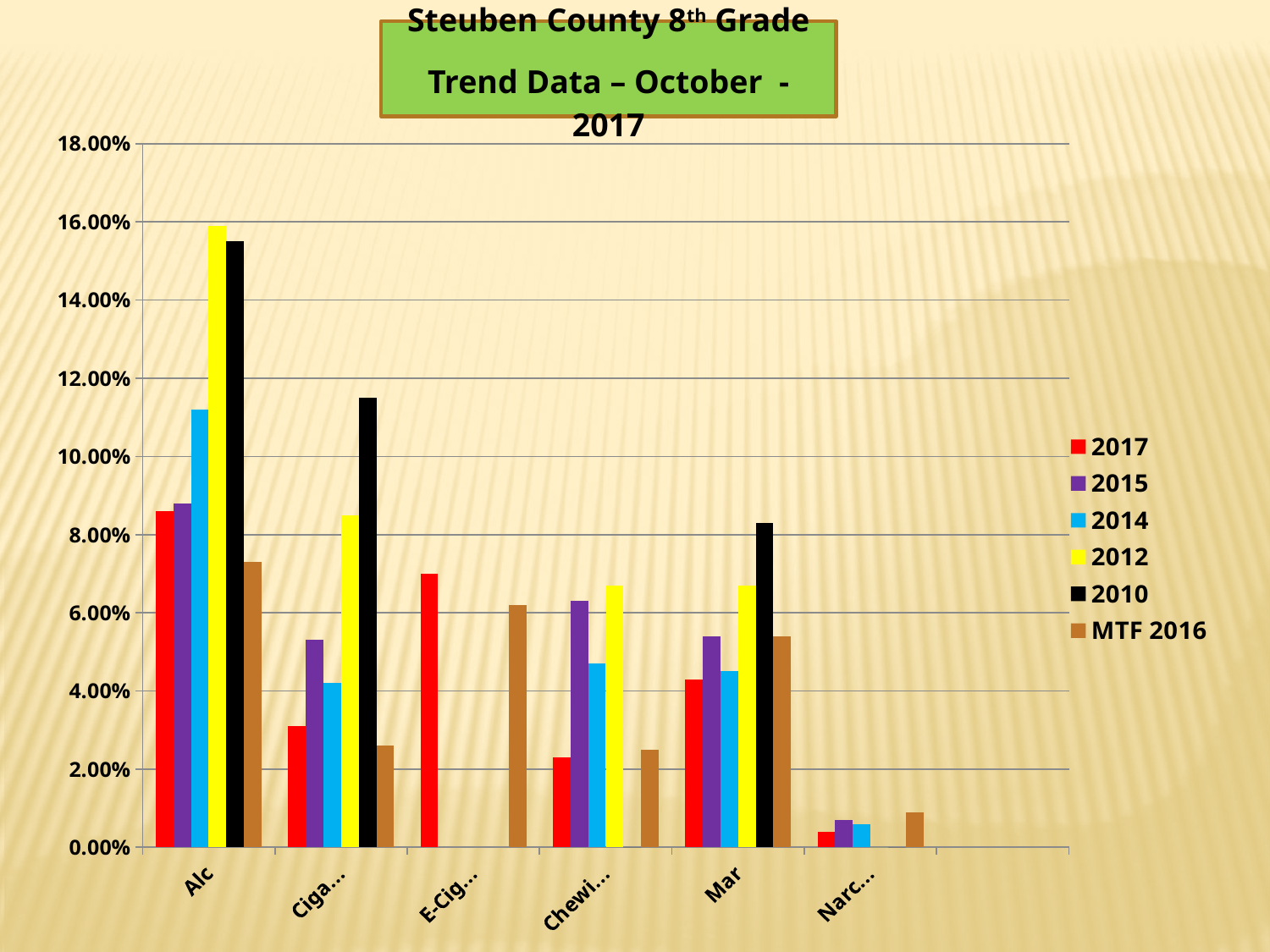
Is the MTF 2016 value for Alc greater or less than 8.00%? less How many labelled categories are shown on the x axis? 6 Is the 2014 value for Alc greater or less than 10.00%? greater How many series does the legend list? 6 What kind of chart is shown on the slide? bar chart Which is larger, the 2014 value for Alc or the 2014 value for Mar? Alc Which series has the highest value for the Mar category? 2010 Which is larger, the 2017 value for Alc or the 2017 value for Mar? Alc What colour represents the 2012 series in the legend? yellow Which series has the lowest value for the Alc category? MTF 2016 Is the 2015 value for Mar greater or less than 4.00%? greater